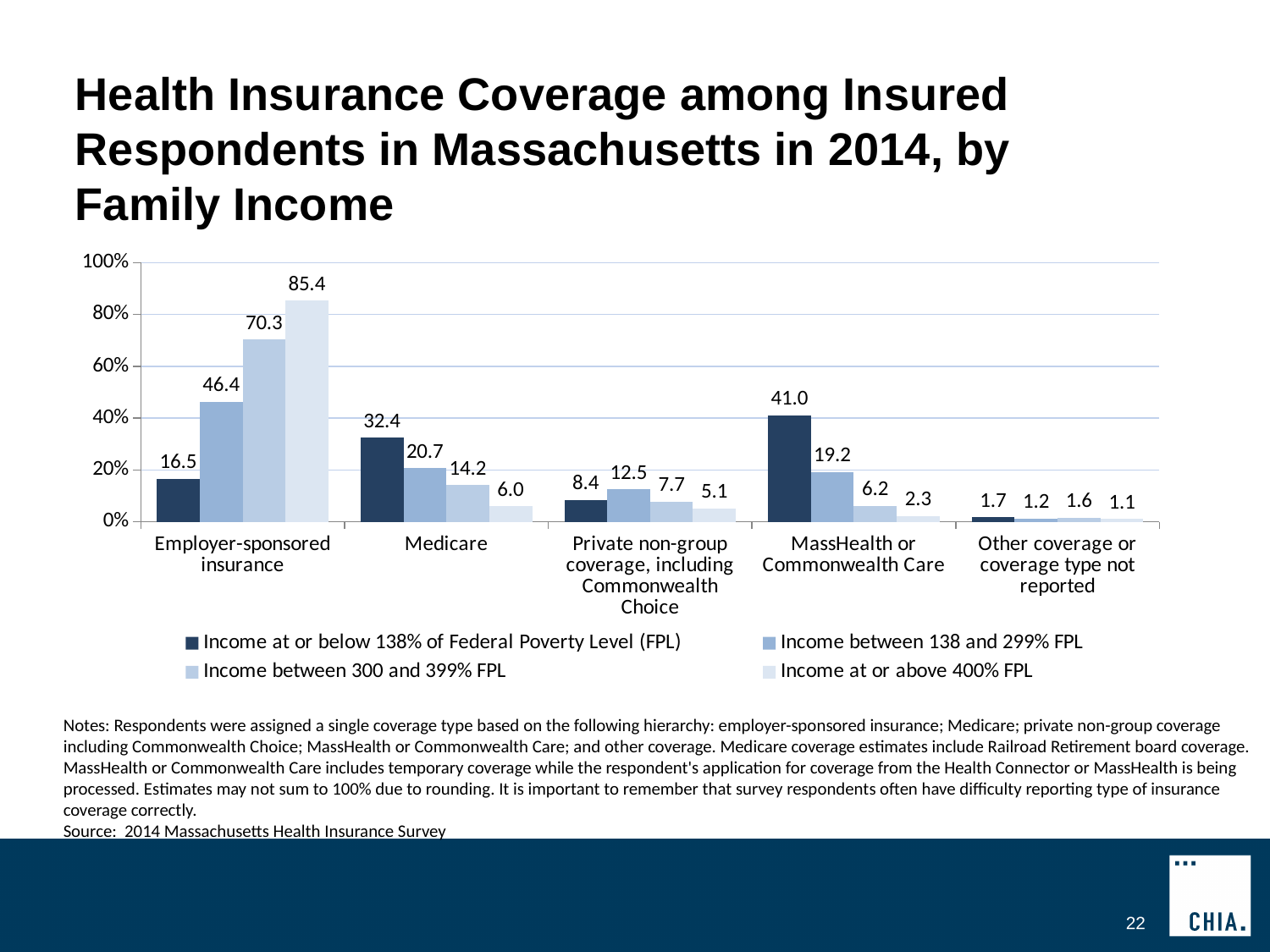
Which category has the highest value for the 'Income at or below 138% of Federal Poverty Level (FPL)' series? MassHealth or Commonwealth Care How many series does the legend list? 4 How many coverage-type categories are shown on the x axis? 5 What is the value for MassHealth or Commonwealth Care for the 'Income between 138 and 299% FPL' series? 19.2 What kind of chart is shown on the slide? bar chart For Private non-group coverage, including Commonwealth Choice, which series has the larger value: 'Income between 138 and 299% FPL' or 'Income between 300 and 399% FPL'? Income between 138 and 299% FPL Which category has the lowest value for the 'Income at or above 400% FPL' series? Other coverage or coverage type not reported What is the difference between the 'Income at or above 400% FPL' and 'Income at or below 138% of Federal Poverty Level (FPL)' values for Employer-sponsored insurance? 68.9 Is the value for Employer-sponsored insurance for the 'Income between 300 and 399% FPL' series greater or less than 60%? greater What is the value for Employer-sponsored insurance for the 'Income at or above 400% FPL' series? 85.4 What is the value for Medicare for the 'Income at or below 138% of Federal Poverty Level (FPL)' series? 32.4 What is the source cited for the chart data? 2014 Massachusetts Health Insurance Survey